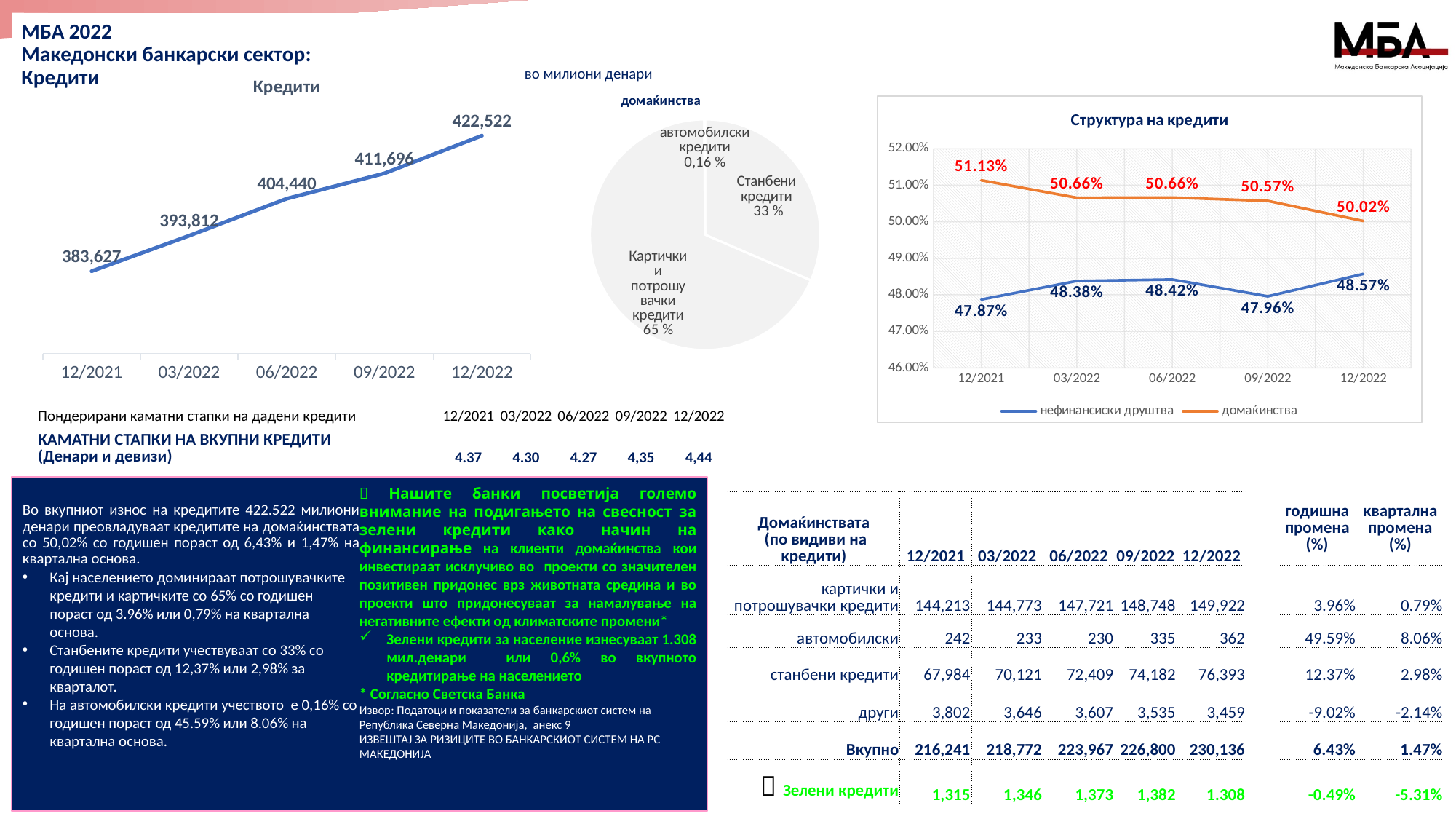
In the 'Кредити' line chart, what is the difference between the 12/2022 value and the 12/2021 value? 38,895 In the 'Структура на кредити' chart, what is the value for 'домаќинства' at 12/2022? 50.02% In the 'Кредити' line chart, what is the value for 12/2021? 383,627 In the 'Структура на кредити' chart, what is the value for 'нефинансиски друштва' at 09/2022? 47.96% What kind of chart is the 'Кредити' chart at the top left of the slide? line chart In the 'домаќинства' pie chart, which slice is the smallest? автомобилски кредити In the 'домаќинства' pie chart, what share do 'Станбени кредити' have? 33 % How many series does the legend of the 'Структура на кредити' chart list? 2 In the 'домаќинства' pie chart, which slice is the largest? Картички и потрошувачки кредити In the 'Кредити' line chart, do the values rise or fall from 12/2021 to 12/2022? rise In the 'Кредити' line chart, what is the value for 12/2022? 422,522 How many data points are plotted in the 'Кредити' line chart? 5